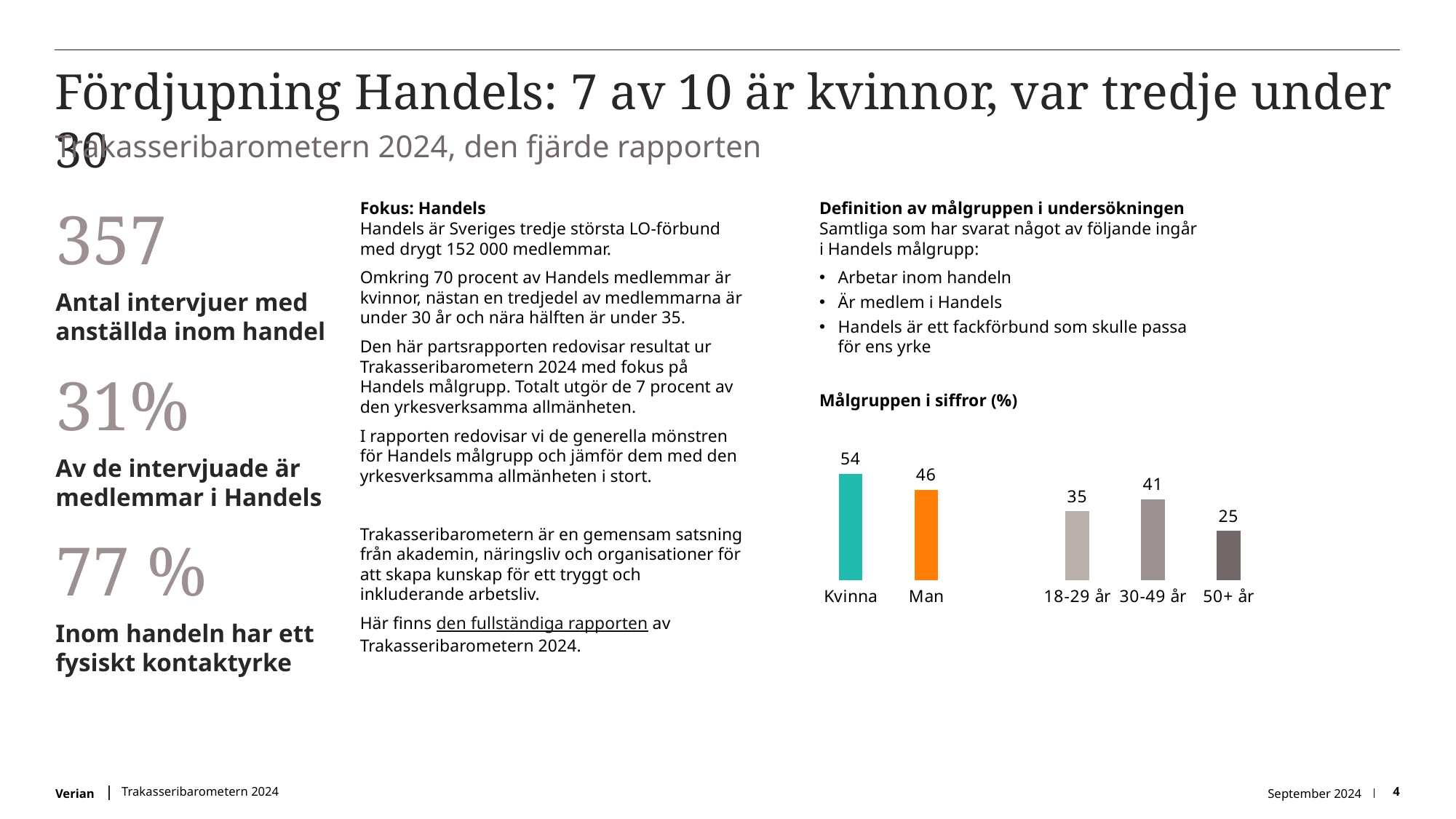
What is the value for Kvinna in the 'Målgruppen i siffror (%)' chart? 54 What is the value for 18-29 år in the 'Målgruppen i siffror (%)' chart? 35 What is the value for 30-49 år in the 'Målgruppen i siffror (%)' chart? 41 Which is larger in the 'Målgruppen i siffror (%)' chart, 18-29 år or 30-49 år? 30-49 år What is the value for 50+ år in the 'Målgruppen i siffror (%)' chart? 25 How many bars are shown in the 'Målgruppen i siffror (%)' chart? 5 What is the difference between the values for Kvinna and Man in the 'Målgruppen i siffror (%)' chart? 8 What kind of chart is 'Målgruppen i siffror (%)'? Bar chart What is the value for Man in the 'Målgruppen i siffror (%)' chart? 46 Which category has the highest value in the 'Målgruppen i siffror (%)' chart? Kvinna Which age group has the lowest value in the 'Målgruppen i siffror (%)' chart? 50+ år What is the title of the chart on the slide? Målgruppen i siffror (%)